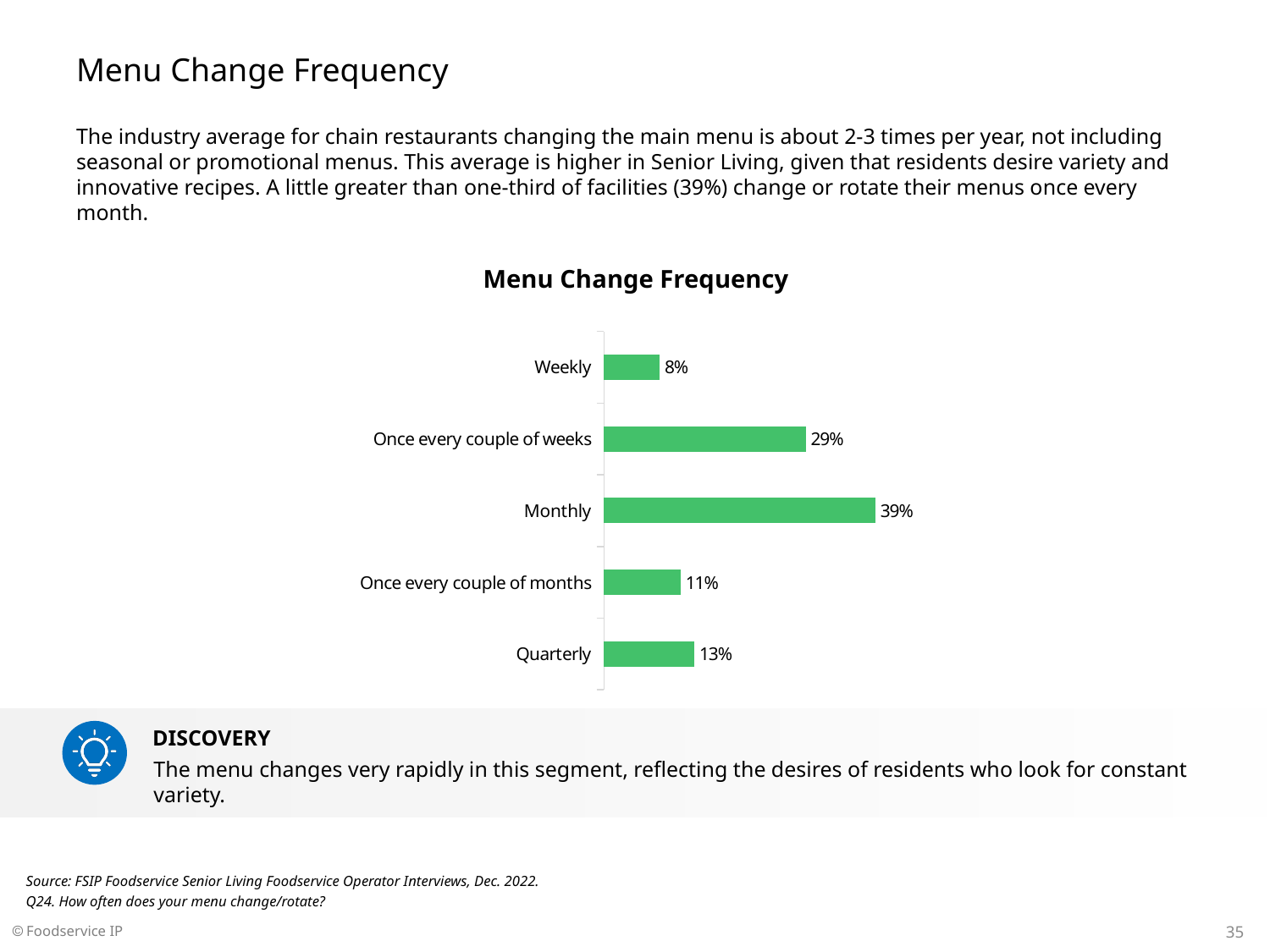
How many categories are shown in the chart? 5 What is the difference between 'Quarterly' and 'Once every couple of months'? 2% Which is larger, the value for 'Once every couple of weeks' or the value for 'Quarterly'? Once every couple of weeks What percentage of facilities change their menu weekly? 8% What is the value for 'Once every couple of weeks'? 29% Which menu change frequency has the highest percentage? Monthly What is the value for 'Quarterly'? 13% What percentage of facilities change their menu monthly? 39% What is the title of the chart? Menu Change Frequency What type of chart is shown on the slide? Bar chart What is the difference between the Monthly and Weekly values? 31% Which menu change frequency has the lowest percentage? Weekly